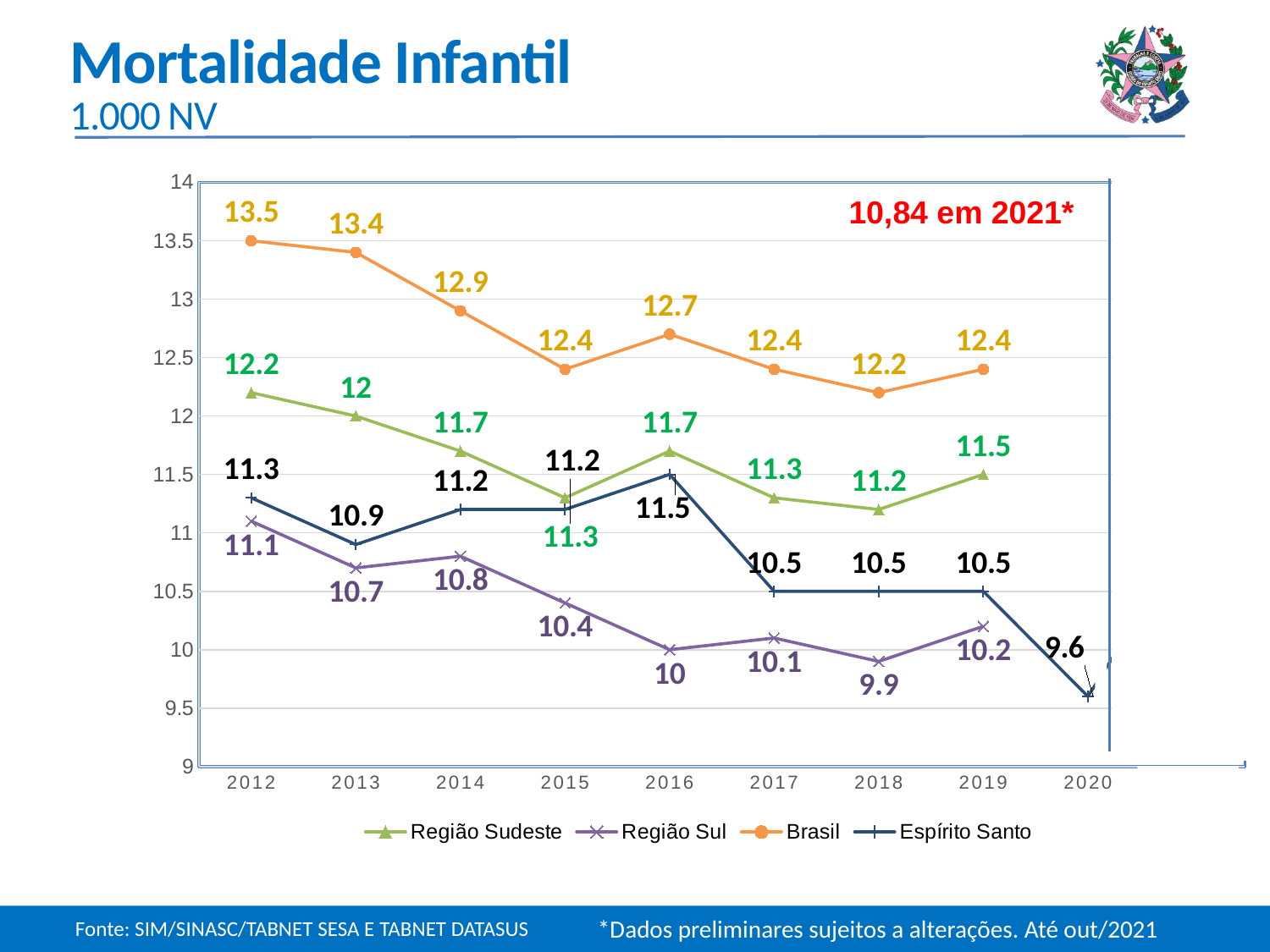
How many series does the legend list? 4 What type of chart is shown on the slide? line chart What is the value for Região Sudeste in 2016? 11.7 What is the difference between the Brasil value and the Espírito Santo value in 2019? 1.9 Does the Espírito Santo series rise or fall from 2016 to 2020? fall In which year is the Brasil series at its highest? 2012 What is the value for Região Sul in 2018? 9.9 In which year is the Região Sul series at its lowest? 2018 How many years are shown on the x axis? 9 What is the value for Espírito Santo in 2020? 9.6 What is the value for Brasil in 2012? 13.5 Which is larger in 2013: the value for Espírito Santo or the value for Região Sul? Espírito Santo